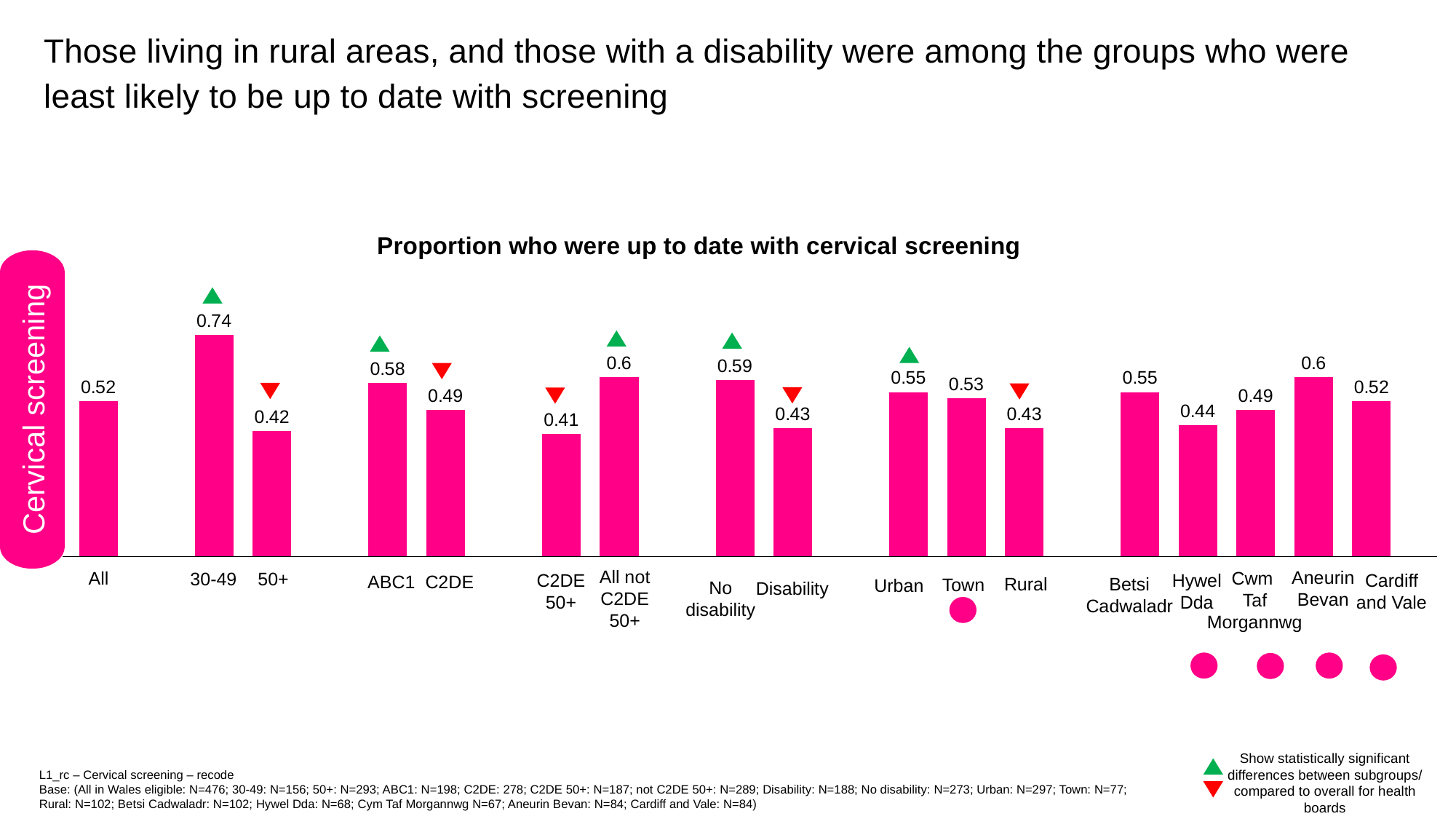
What is the value for Hywel Dda? 0.44 What kind of chart is shown? Bar chart What is the difference between the values for No disability and Disability? 0.16 What is the title of the chart? Proportion who were up to date with cervical screening Which is larger, the value for Urban or the value for Rural? Urban Which category has the highest value? 30-49 What is the value for Rural? 0.43 What is the value for the All group? 0.52 What is the difference between the values for 30-49 and 50+? 0.32 How many categories are plotted on the chart? 17 Which category has the lowest value? C2DE 50+ What is the value for the 30-49 group? 0.74